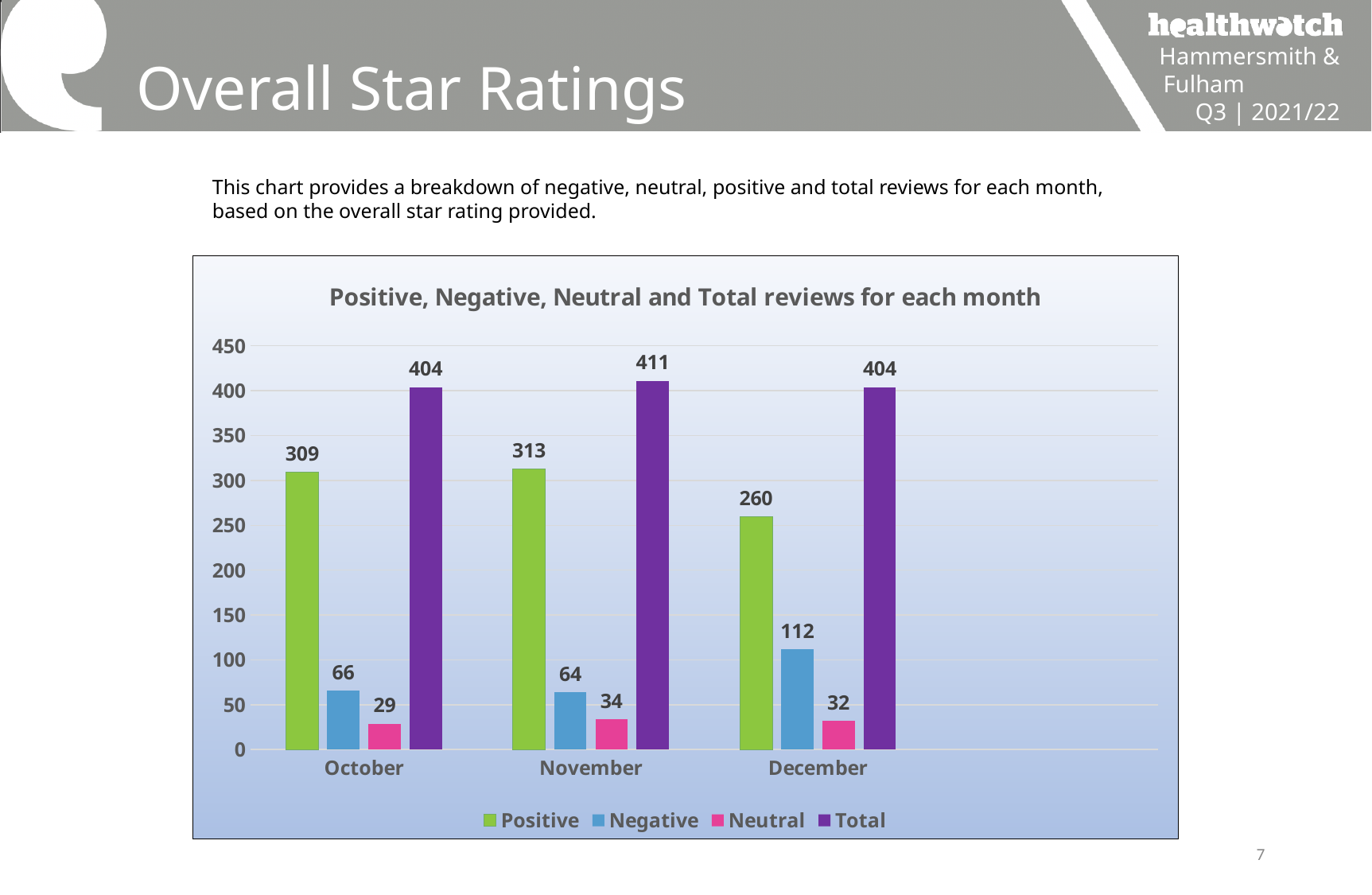
What is the number of Negative reviews in December? 112 How many series does the legend list? 4 What is the difference between Positive reviews in November and December? 53 Which month has the highest number of Positive reviews? November What is the title of the chart? Positive, Negative, Neutral and Total reviews for each month Which month has the lowest number of Neutral reviews? October What is the number of Neutral reviews in November? 34 Which is larger, the number of Negative reviews in October or in December? December What is the Total number of reviews in November? 411 How many months are shown on the x axis? 3 What kind of chart is shown on the slide? Bar chart What is the number of Positive reviews in October? 309